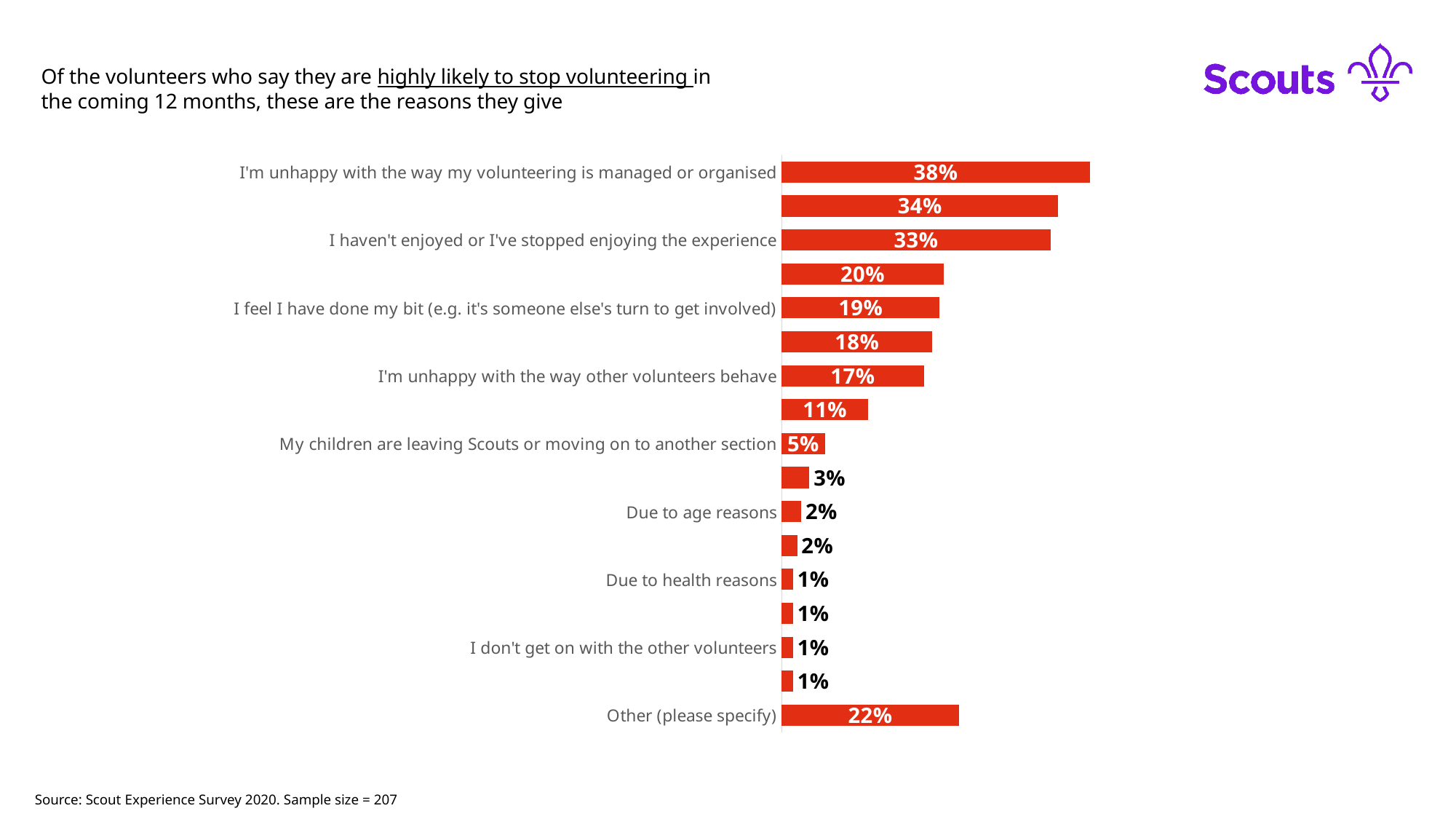
What is the difference between the value for "I'm unhappy with the way my volunteering is managed or organised" and the value for "I haven't enjoyed or I've stopped enjoying the experience"? 5% Which is larger: the value for "I feel I have done my bit" or the value for "Other (please specify)"? Other (please specify) What is the difference between the value for "My children are leaving Scouts or moving on to another section" and the value for "Due to health reasons"? 4% What value is shown for "I haven't enjoyed or I've stopped enjoying the experience"? 33% What percentage is shown for "Other (please specify)"? 22% Which reason has the highest percentage on the chart? I'm unhappy with the way my volunteering is managed or organised What type of chart is shown on the slide? Bar chart What percentage is given for "Due to age reasons"? 2% What value is shown for "I'm unhappy with the way other volunteers behave"? 17% What percentage of volunteers highly likely to stop volunteering say they are unhappy with the way their volunteering is managed or organised? 38% How many bars are plotted on the chart? 17 What is the lowest percentage value shown on the chart? 1%